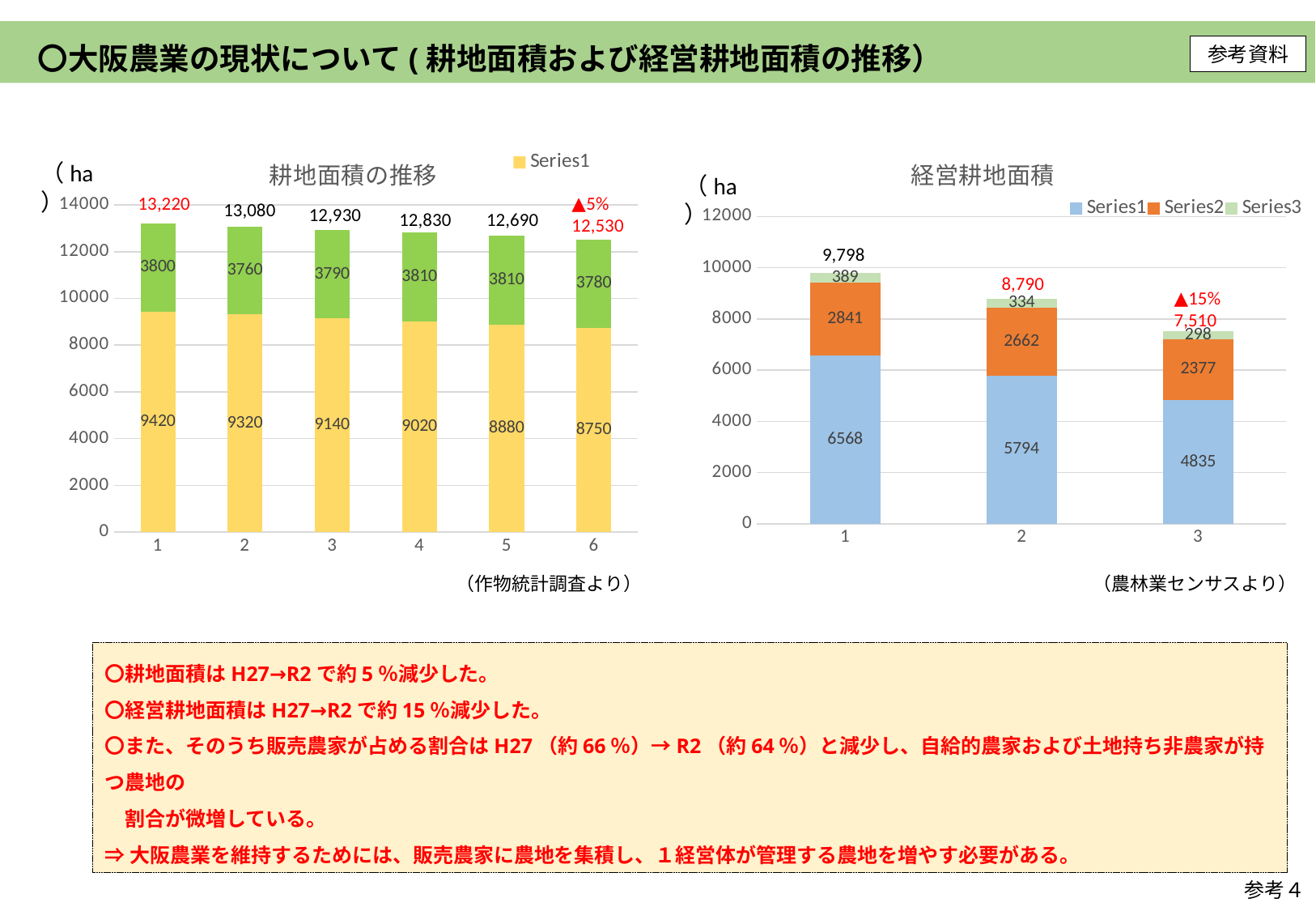
In the chart titled 耕地面積の推移, what is the value of the green segment for category 3? 3790 In the chart titled 経営耕地面積, is the Series2 value for category 1 larger or smaller than the Series2 value for category 3? larger In the chart titled 耕地面積の推移, how many categories are shown on the x axis? 6 In the chart titled 経営耕地面積, how many series does the legend list? 3 In the chart titled 耕地面積の推移, which category has the lowest total value? 6 In the chart titled 経営耕地面積, what is the value of Series3 for category 2? 334 In the chart titled 耕地面積の推移, do the total values rise or fall from category 1 to category 6? fall In the chart titled 耕地面積の推移, what is the total value labelled above the bar for category 1? 13,220 In the chart titled 経営耕地面積, what is the value of Series1 for category 3? 4835 In the chart titled 経営耕地面積, what is the total value labelled above the bar for category 1? 9,798 In the chart titled 耕地面積の推移, what is the value of the yellow segment for category 6? 8750 In the chart titled 耕地面積の推移, what is the difference between the yellow segment values for category 1 and category 6? 670